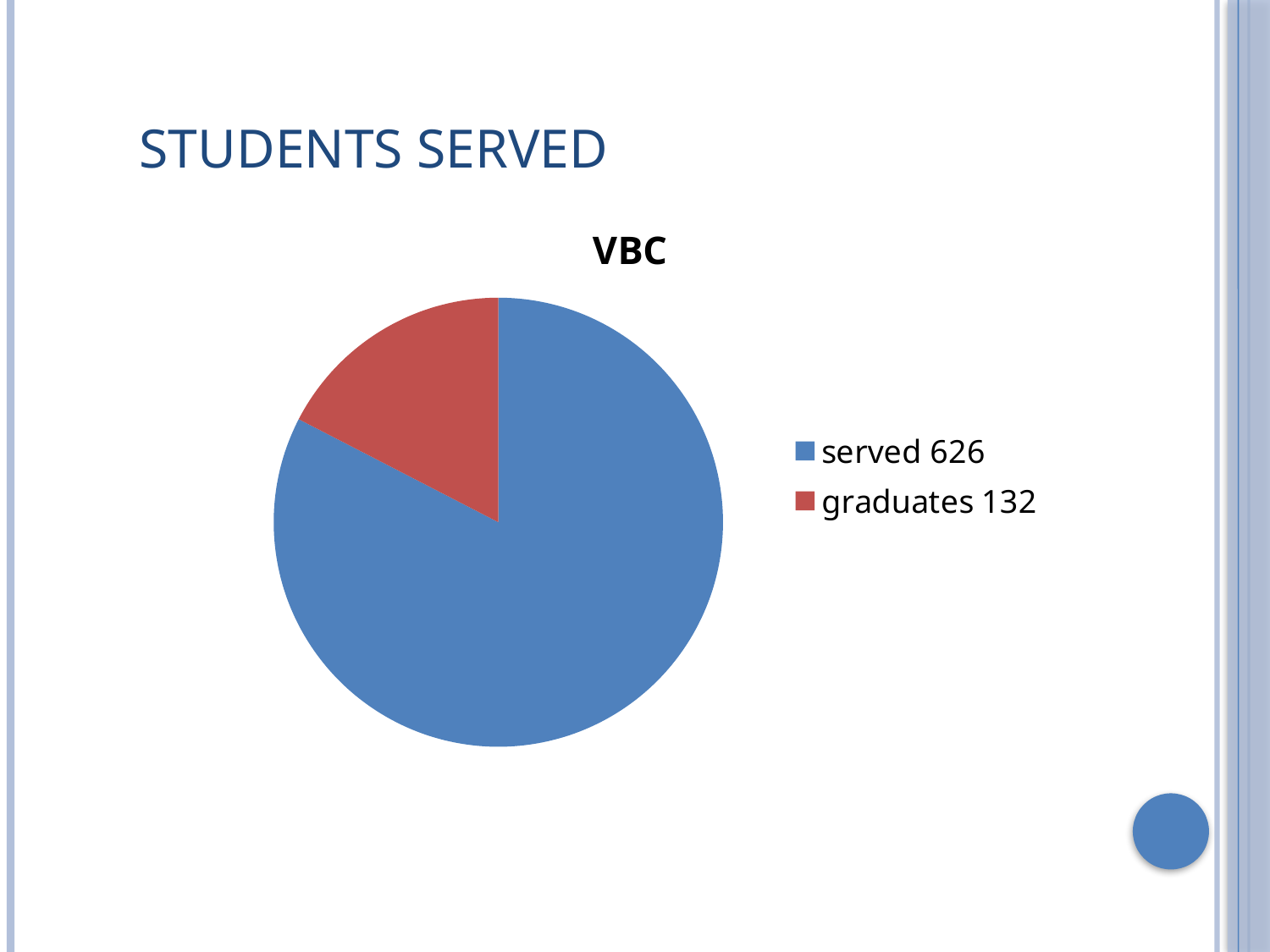
What is the number of graduates according to the legend? 132 How many entries does the legend list? 2 Which is larger, the number served or the number of graduates? served What type of chart is shown on the slide? pie chart What is the difference between the number served and the number of graduates? 494 What is the total of the two values shown in the legend? 758 What colour is the slice for graduates? red Which category has the smallest slice of the pie? graduates Which category has the largest slice of the pie? served What is the title of the pie chart? VBC How many slices does the pie chart have? 2 What is the number of students served according to the legend? 626